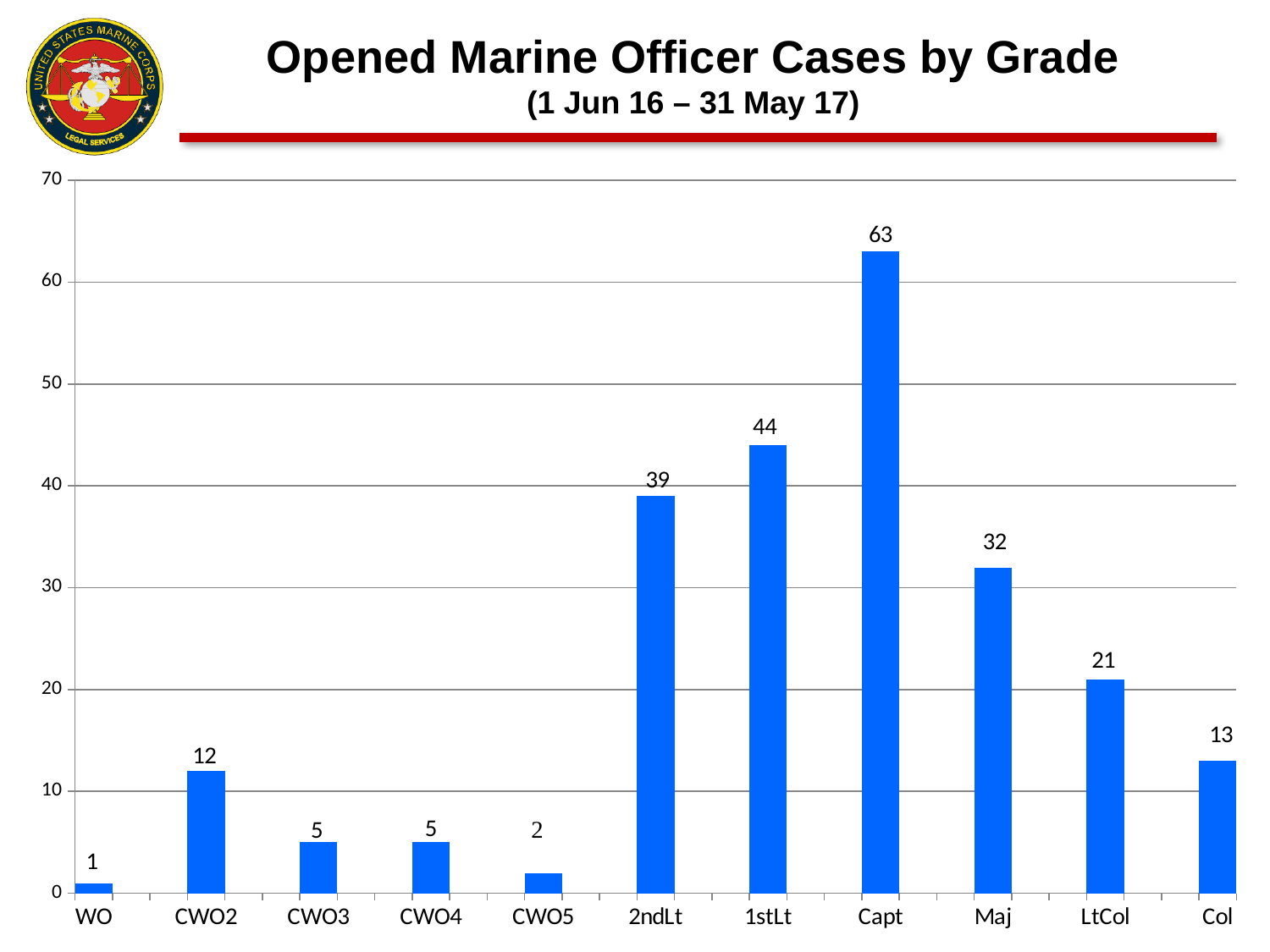
What is the difference between the values for Capt and 1stLt? 19 How many grades are shown on the x axis? 11 What date range is given in the chart title? 1 Jun 16 – 31 May 17 Which grade has the lowest number of opened cases? WO What is the value for LtCol? 21 Which grade has the highest number of opened cases? Capt What kind of chart is shown on the slide? bar chart What is the difference between the values for Maj and Col? 19 What is the value for CWO2? 12 Is the value for 1stLt greater or less than 40? greater Which is larger, the value for 2ndLt or the value for Maj? 2ndLt What is the value for Capt? 63